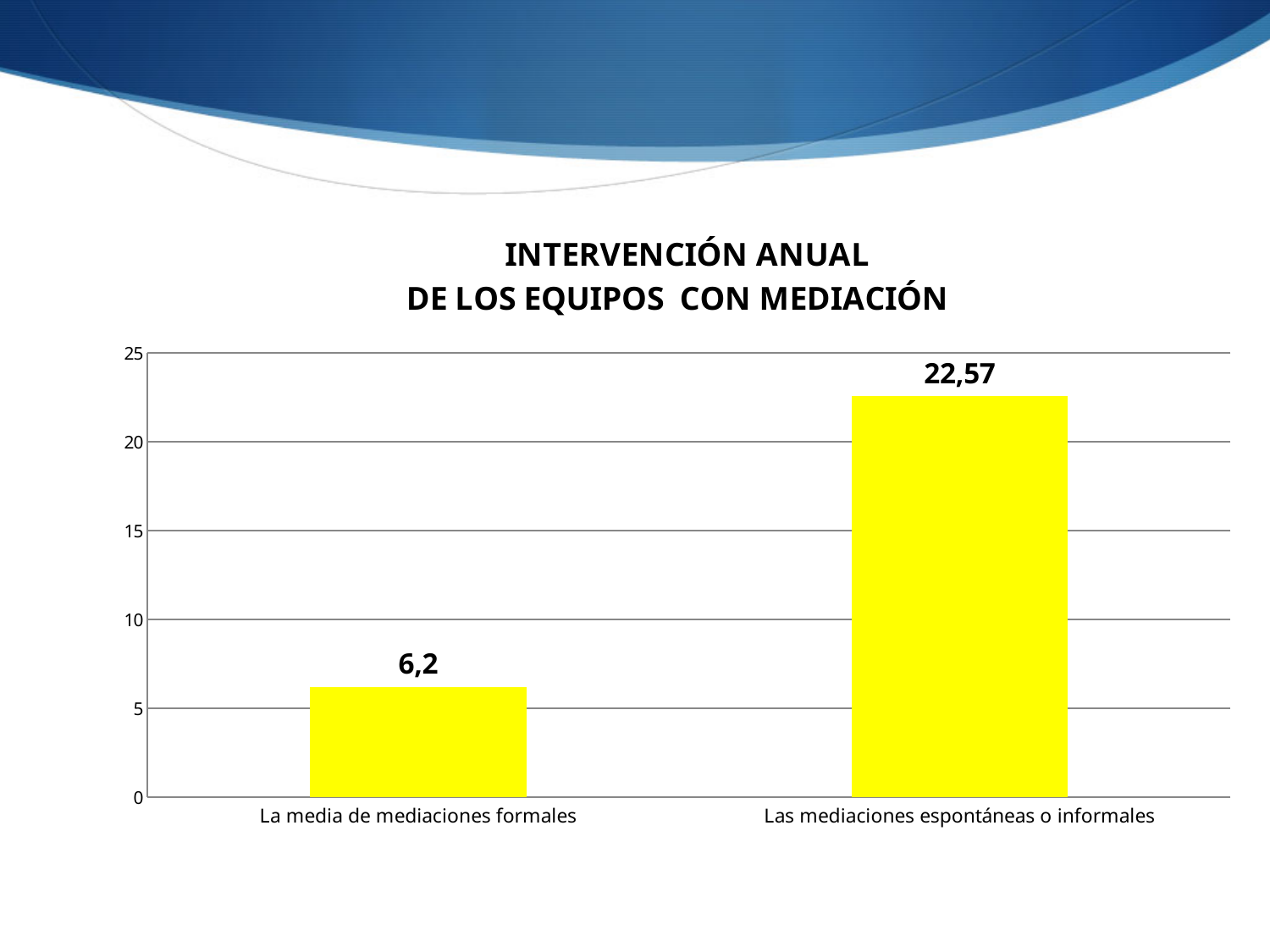
How many categories are shown in the chart? 2 Which is larger: the value for "La media de mediaciones formales" or for "Las mediaciones espontáneas o informales"? Las mediaciones espontáneas o informales Is the value for "Las mediaciones espontáneas o informales" greater or less than 20? greater What is the title of the chart? INTERVENCIÓN ANUAL DE LOS EQUIPOS CON MEDIACIÓN Is the value for "La media de mediaciones formales" greater or less than 10? less Which category has the highest value? Las mediaciones espontáneas o informales What kind of chart is shown on the slide? Bar chart What is the difference between the values for "Las mediaciones espontáneas o informales" and "La media de mediaciones formales"? 16,37 What is the value for "Las mediaciones espontáneas o informales"? 22,57 Which category has the lowest value? La media de mediaciones formales What colour are the bars in the chart? Yellow What is the value for "La media de mediaciones formales"? 6,2